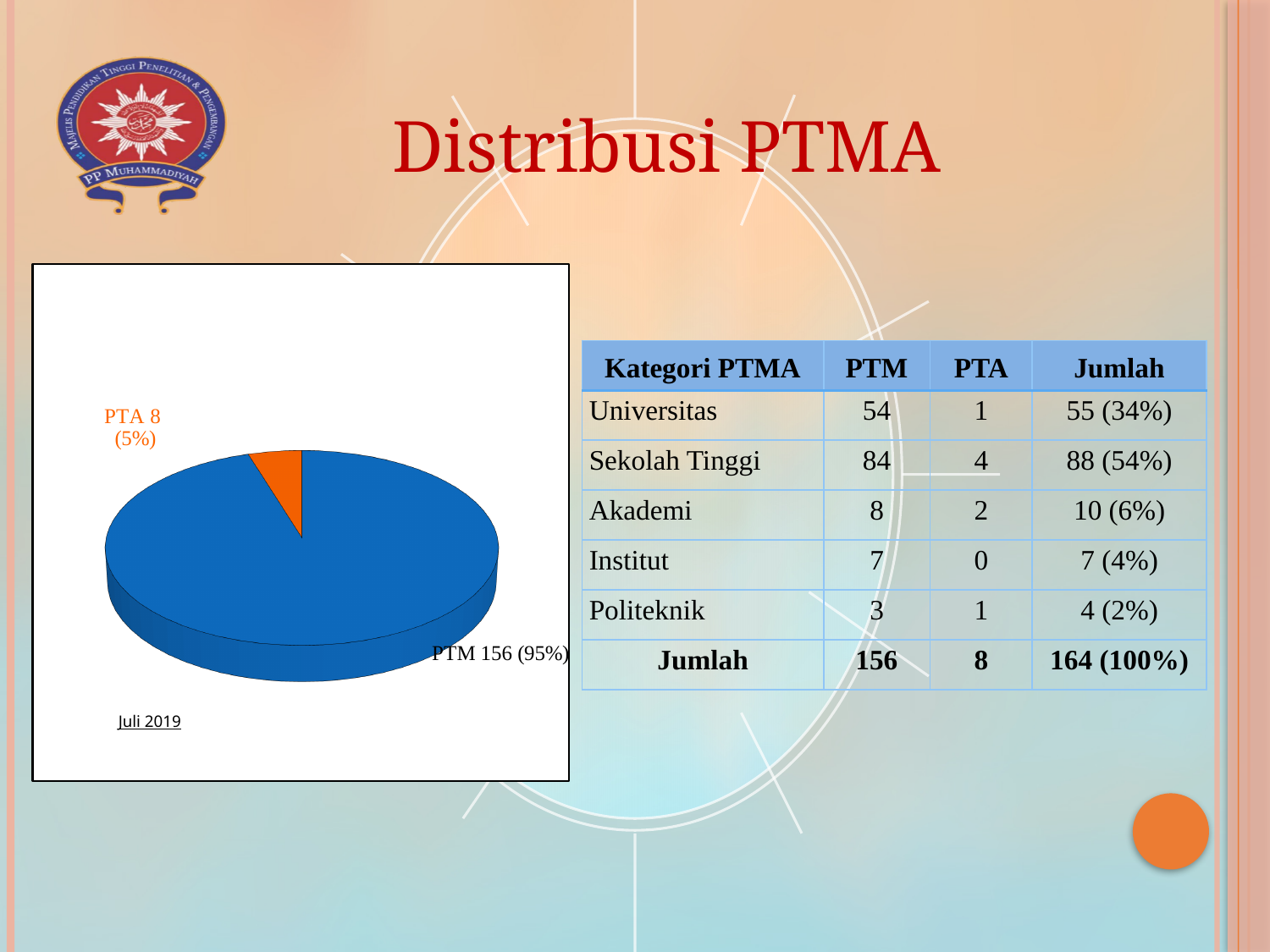
What colour is the PTA slice in the pie chart? orange What kind of chart is shown on the left of the slide? pie chart How many slices does the pie chart have? 2 Which is larger in the pie chart, PTM or PTA? PTM What share of the pie does PTA represent? 5% Which slice of the pie chart is the smallest? PTA Which slice of the pie chart is the largest? PTM What is the value shown for PTM in the pie chart? 156 What date label is shown below the pie chart? Juli 2019 What share of the pie does PTM represent? 95% What is the value shown for PTA in the pie chart? 8 What is the difference between the PTM and PTA values in the pie chart? 148